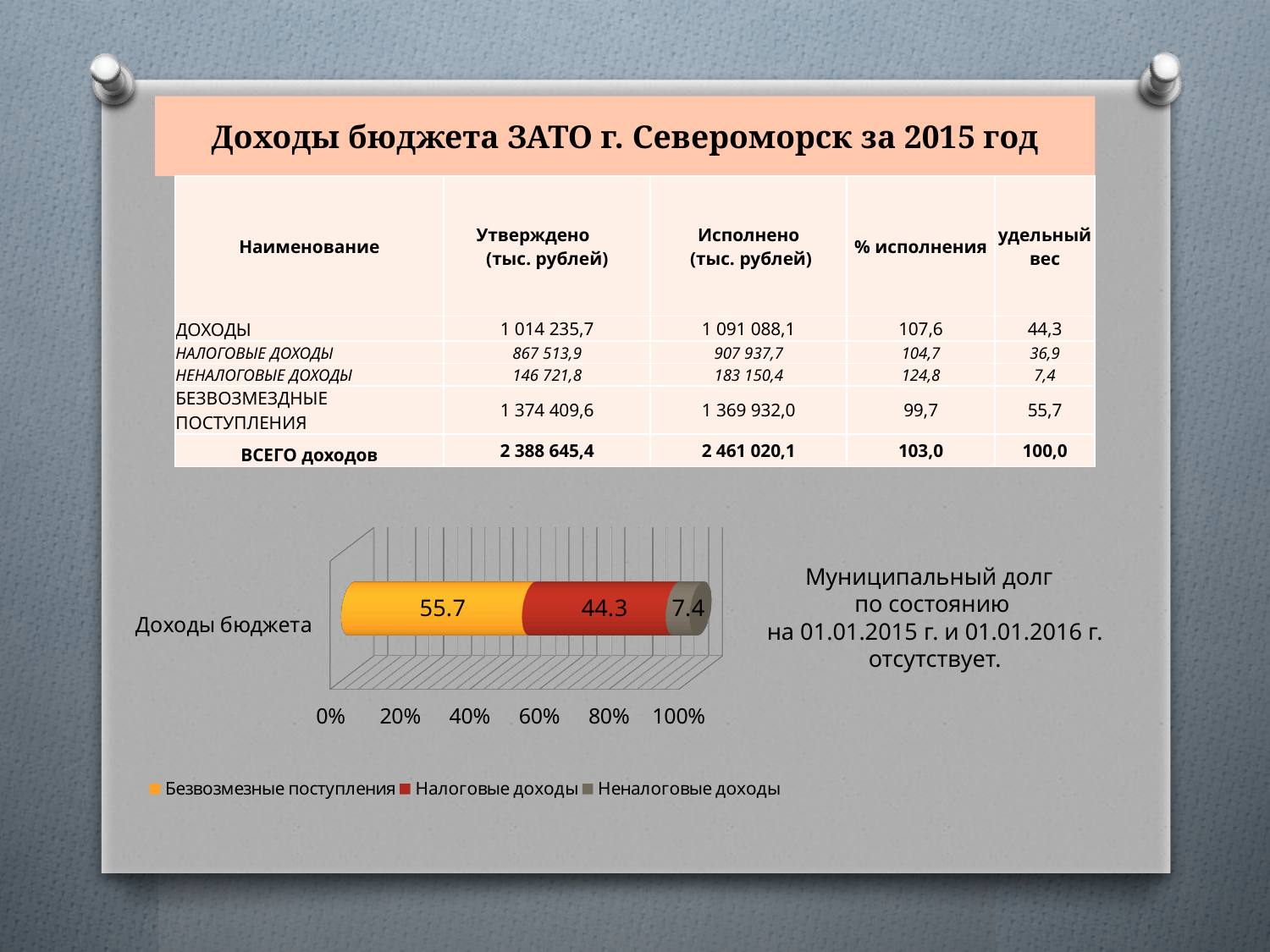
What is the category label shown next to the bar in the chart? Доходы бюджета What colour represents Налоговые доходы in the bar chart? red In the bar chart, which is larger: the value for Налоговые доходы or the value for Неналоговые доходы? Налоговые доходы In the bar chart, what is the value for Налоговые доходы? 44.3 How many series does the legend of the bar chart list? 3 In the bar chart, what is the difference between the values for Безвозмезные поступления and Налоговые доходы? 11.4 What kind of chart is shown on the slide? stacked bar chart How many categories are plotted on the bar chart's vertical axis? 1 Which series has the smallest value in the bar chart? Неналоговые доходы In the bar chart, what is the value for Безвозмезные поступления? 55.7 In the bar chart, what is the value for Неналоговые доходы? 7.4 Which series has the largest value in the bar chart? Безвозмезные поступления